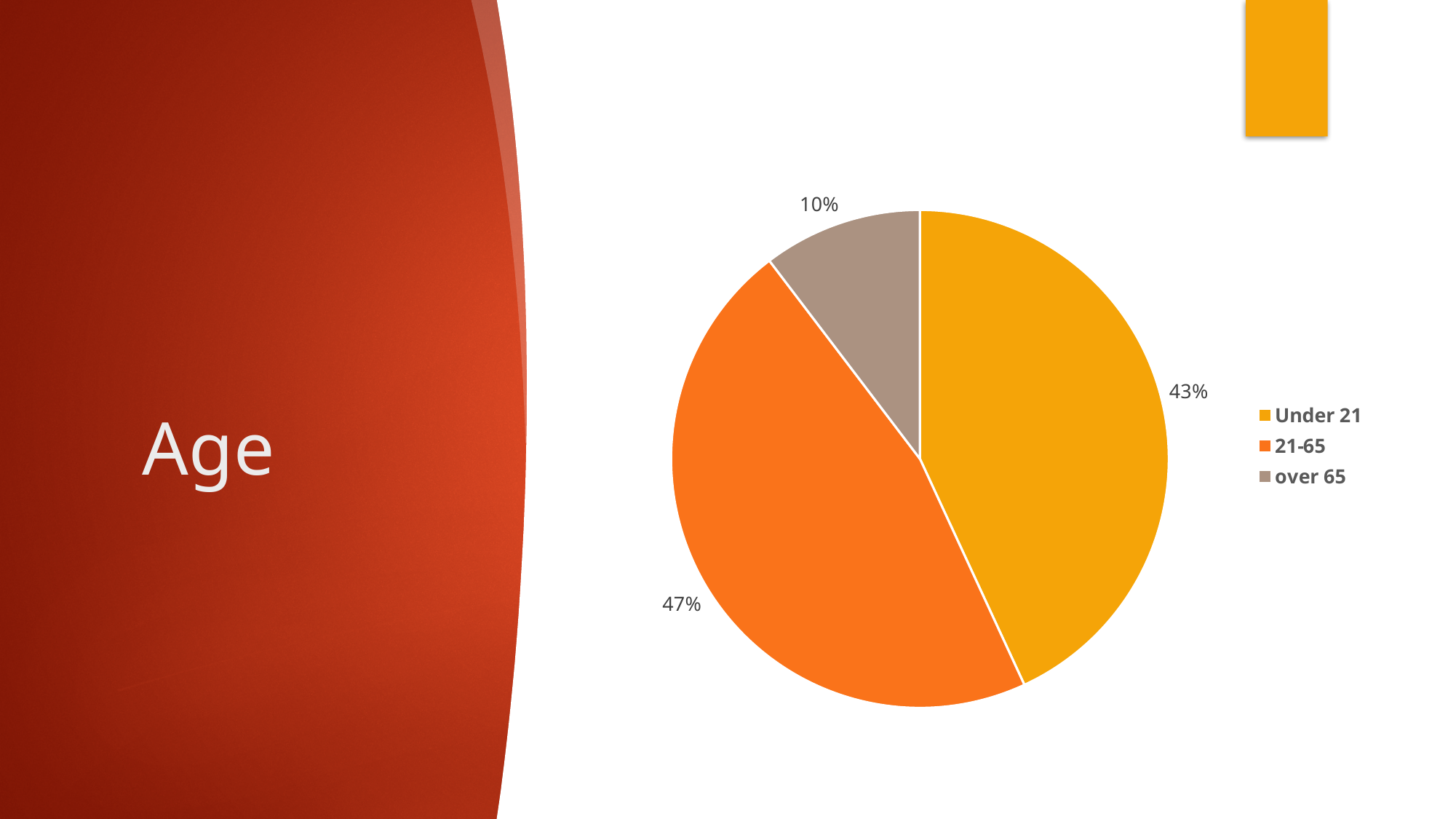
What percentage of the pie is the Under 21 slice? 43% What is the difference in percentage points between the 21-65 slice and the Under 21 slice? 4 Which age group has the largest share of the pie? 21-65 How many slices does the pie chart have? 3 Which is larger, the Under 21 slice or the over 65 slice? Under 21 What is the difference in percentage points between the Under 21 slice and the over 65 slice? 33 What percentage of the pie is the 21-65 slice? 47% What colour is the over 65 slice in the pie chart? grey What type of chart is shown on the slide? pie chart What percentage of the pie is the over 65 slice? 10% What is the title of the slide containing the pie chart? Age Which age group has the smallest share of the pie? over 65